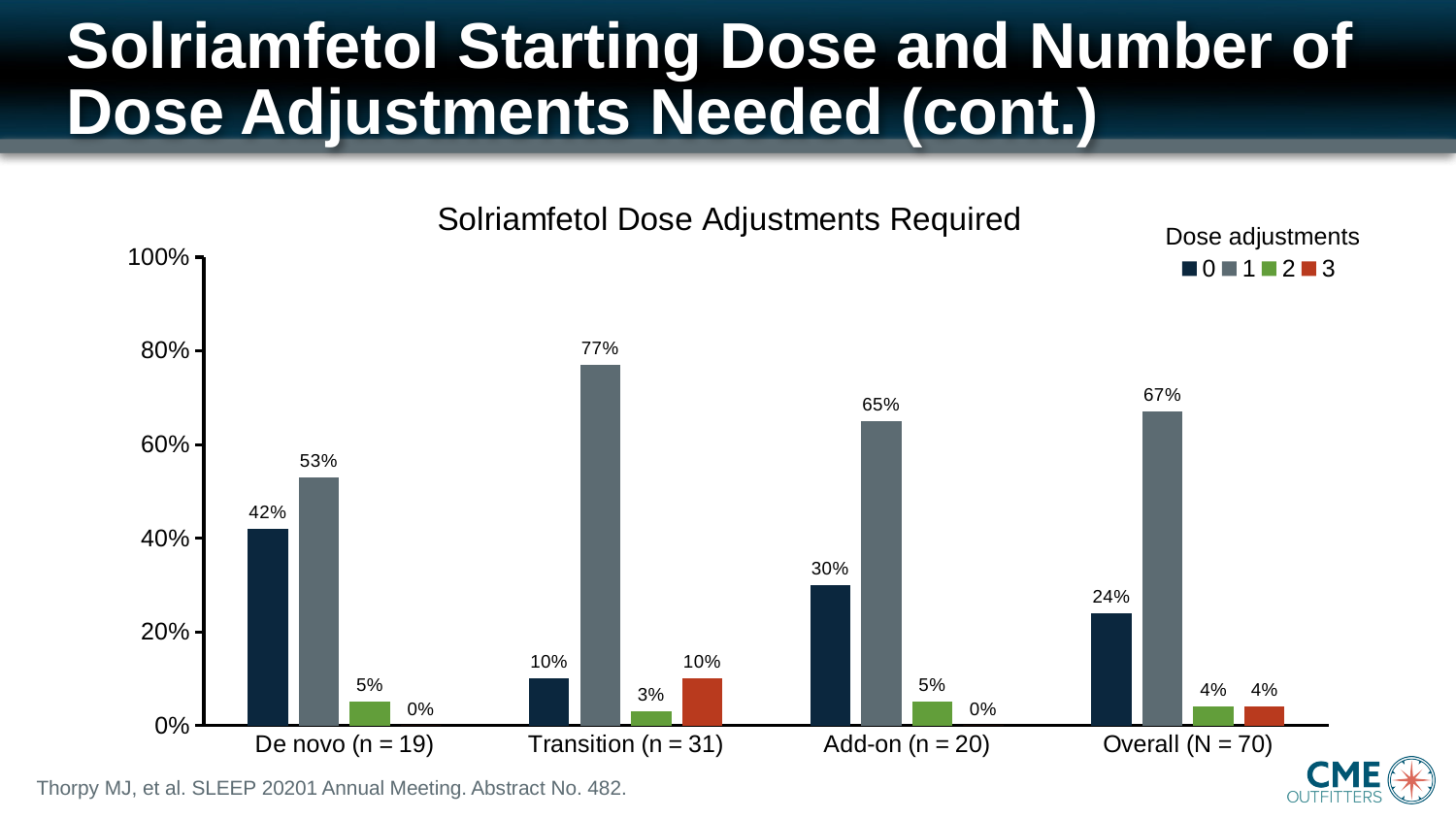
Which is larger: the percentage of the De novo (n = 19) group requiring 0 dose adjustments or the percentage requiring 1 dose adjustment? 1 dose adjustment Is the value for 1 dose adjustment in the Overall (N = 70) group greater or less than 60%? greater What percentage of the Overall (N = 70) group required 0 dose adjustments? 24% What percentage of the De novo (n = 19) group required 2 dose adjustments? 5% What percentage of the Transition (n = 31) group required 1 dose adjustment? 77% What is the title of the chart? Solriamfetol Dose Adjustments Required What kind of chart is shown on the slide? Bar chart Which group has the lowest percentage requiring 0 dose adjustments? Transition (n = 31) How many series does the legend list? 4 Which group has the highest percentage requiring 1 dose adjustment? Transition (n = 31) How many groups are shown on the x axis? 4 What is the difference between the percentage of the Add-on (n = 20) group requiring 1 dose adjustment and the percentage requiring 0 dose adjustments? 35%